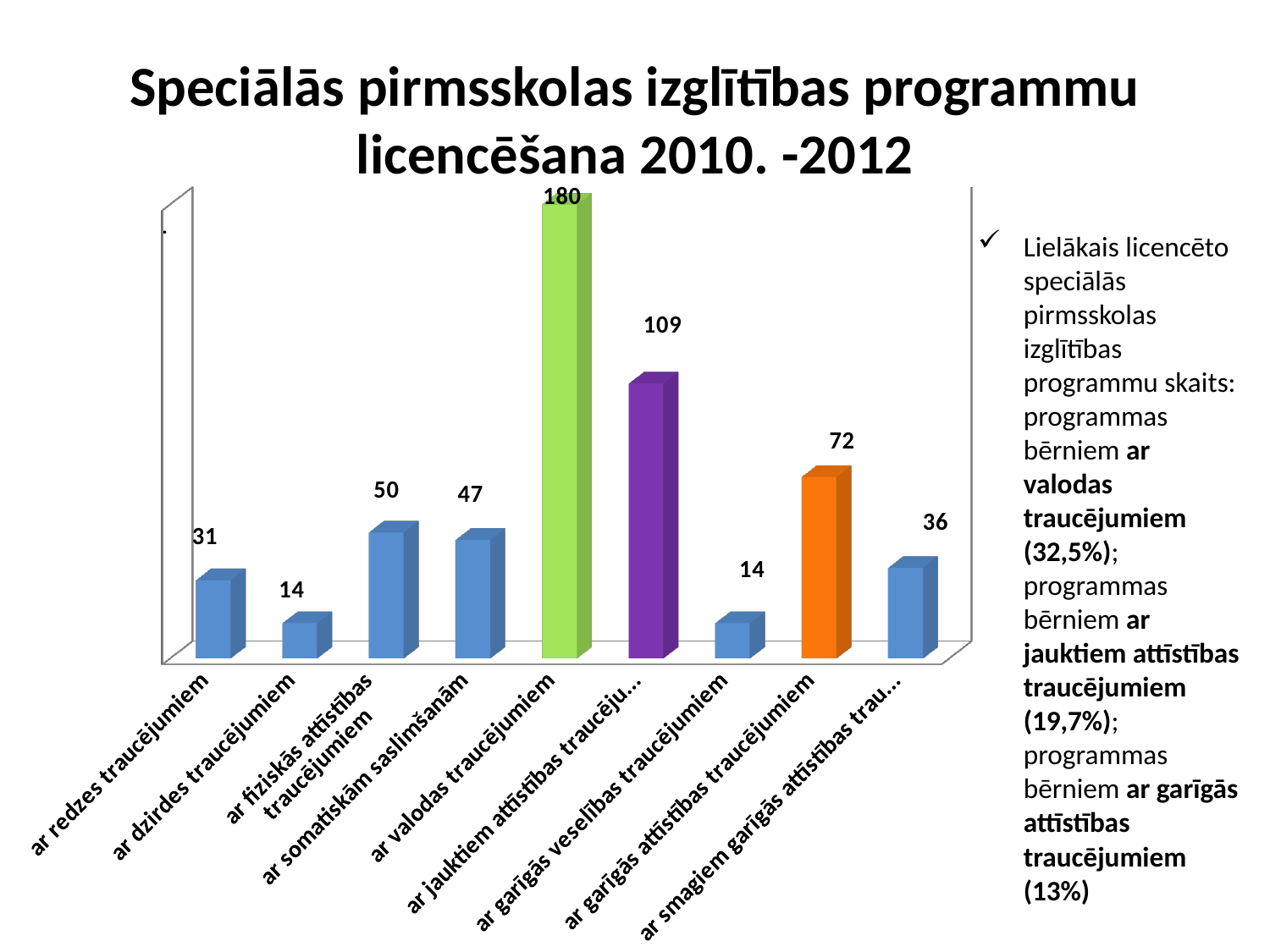
What is the title of the chart? Speciālās pirmsskolas izglītības programmu licencēšana 2010. -2012 What kind of chart is shown on the slide? bar chart What is the value for "ar redzes traucējumiem"? 31 Which category has the highest value? ar valodas traucējumiem What is the difference between the values for "ar valodas traucējumiem" and "ar jauktiem attīstības traucējumiem"? 71 Which is larger, the value for "ar garīgās attīstības traucējumiem" or the value for "ar smagiem garīgās attīstības traucējumiem"? ar garīgās attīstības traucējumiem What is the value for "ar dzirdes traucējumiem"? 14 What is the difference between the values for "ar fiziskās attīstības traucējumiem" and "ar somatiskām saslimšanām"? 3 What is the value for "ar valodas traucējumiem"? 180 What is the value for "ar garīgās attīstības traucējumiem"? 72 What is the value for "ar somatiskām saslimšanām"? 47 How many categories are shown on the chart? 9